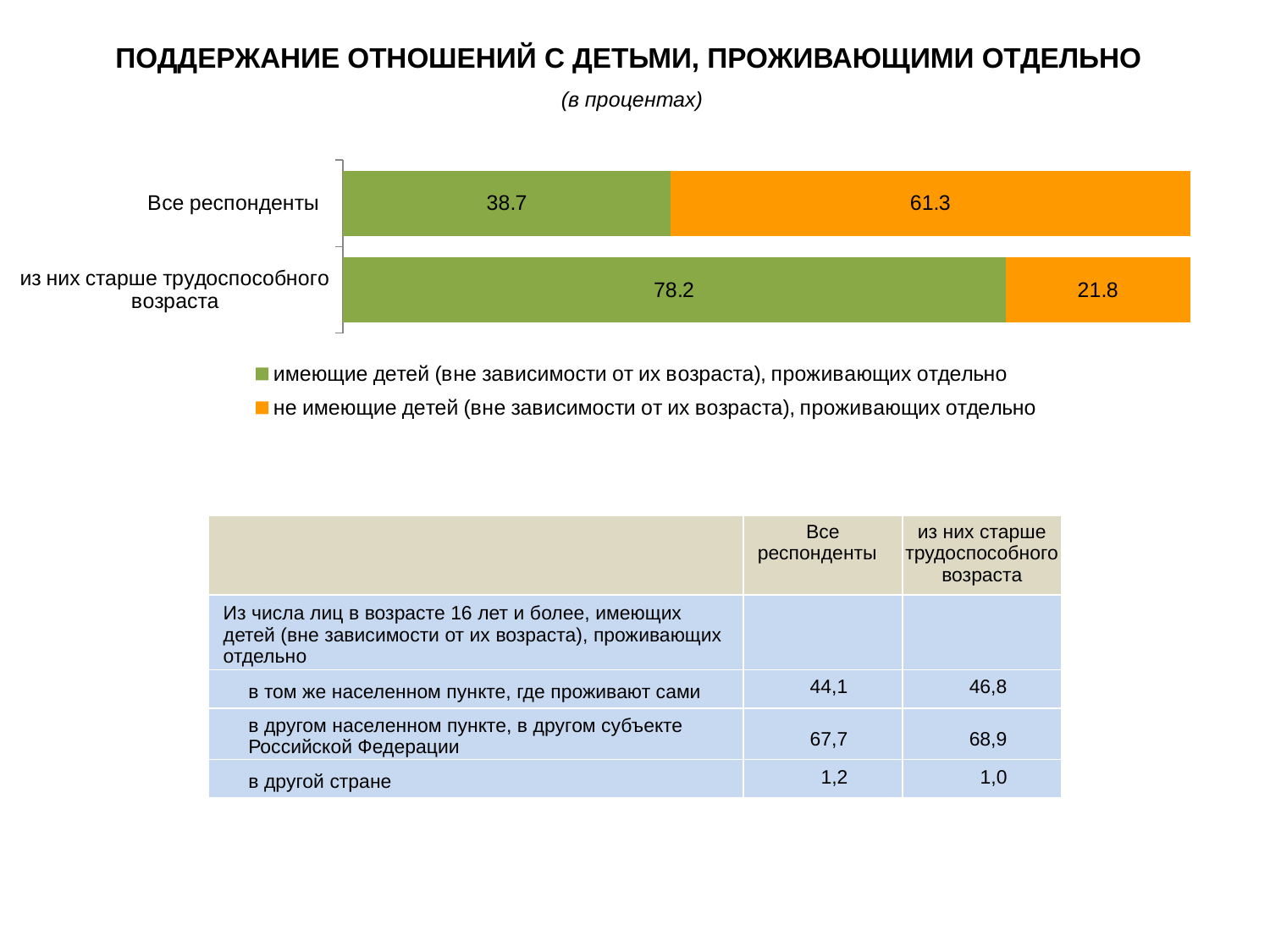
What is the difference between the 'имеющие детей' values for 'из них старше трудоспособного возраста' and 'Все респонденты'? 39.5 Which colour represents 'не имеющие детей (вне зависимости от их возраста), проживающих отдельно' in the chart? Orange How many series does the chart legend list? 2 Which category has the lower value for 'не имеющие детей (вне зависимости от их возраста), проживающих отдельно'? из них старше трудоспособного возраста What is the value for 'не имеющие детей (вне зависимости от их возраста), проживающих отдельно' in the 'из них старше трудоспособного возраста' bar? 21.8 How many categories (bars) are shown in the chart? 2 What type of chart is shown on the slide? Stacked bar chart What is the value for 'не имеющие детей (вне зависимости от их возраста), проживающих отдельно' in the 'Все респонденты' bar? 61.3 What is the value for 'имеющие детей (вне зависимости от их возраста), проживающих отдельно' in the 'Все респонденты' bar? 38.7 What is the total of the stacked bar for 'Все респонденты'? 100 What is the value for 'имеющие детей (вне зависимости от их возраста), проживающих отдельно' in the 'из них старше трудоспособного возраста' bar? 78.2 Which category has the higher value for 'имеющие детей (вне зависимости от их возраста), проживающих отдельно'? из них старше трудоспособного возраста